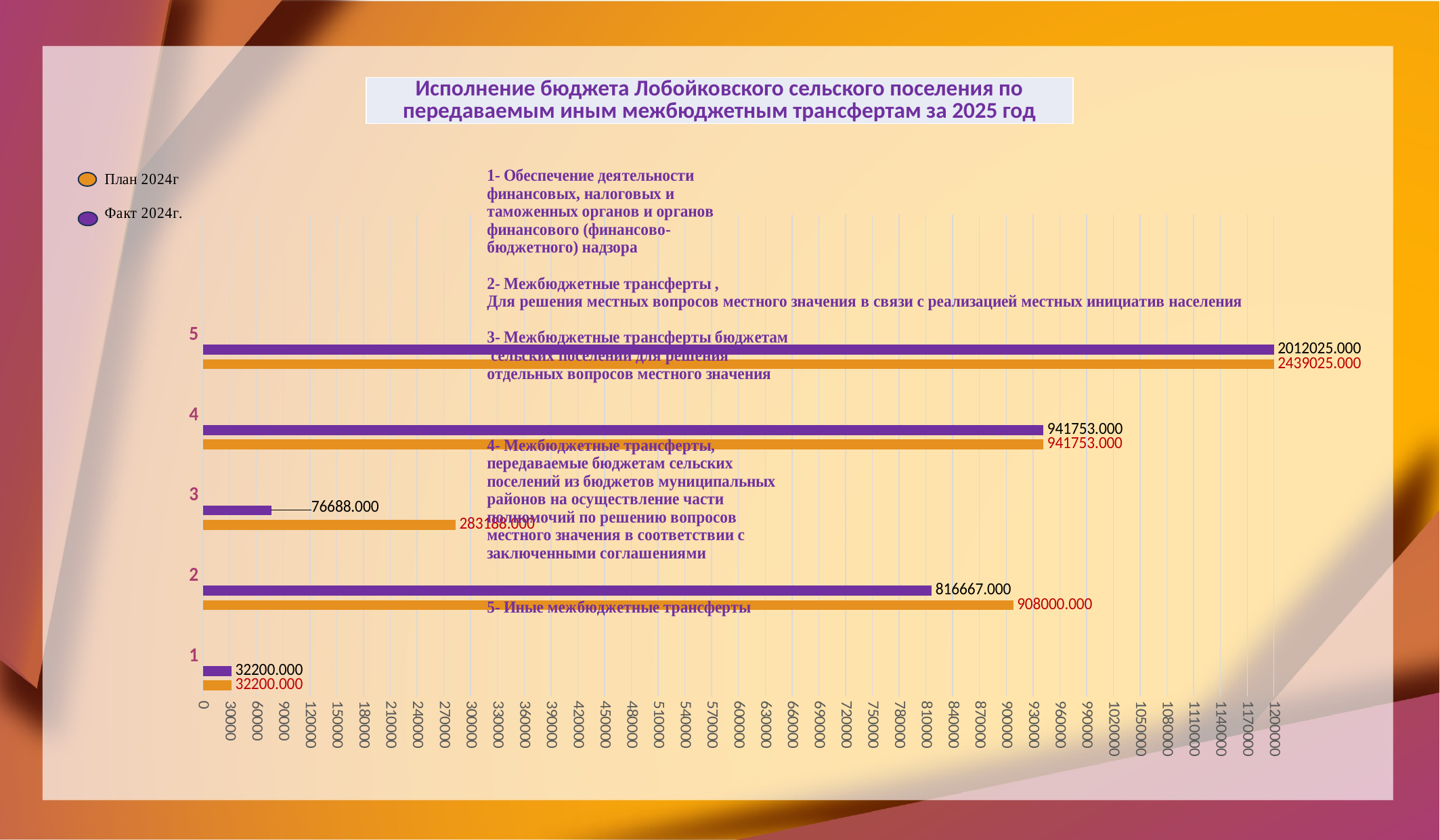
How many series does the legend list? 2 For category 2, which is larger: the План 2024г value or the Факт 2024г. value? План 2024г Which category has the lowest Факт 2024г. value? 1 What is the difference between the План 2024г and Факт 2024г. values for category 5? 427000.000 What kind of chart is shown on the slide? Bar chart What is the Факт 2024г. value for category 1? 32200.000 What is the План 2024г value for category 2? 908000.000 Which category has the highest План 2024г value? 5 What is the Факт 2024г. value for category 5? 2012025.000 What is the План 2024г value for category 3? 283188.000 What is the difference between the План 2024г and Факт 2024г. values for category 3? 206500.000 How many categories are shown on the chart? 5